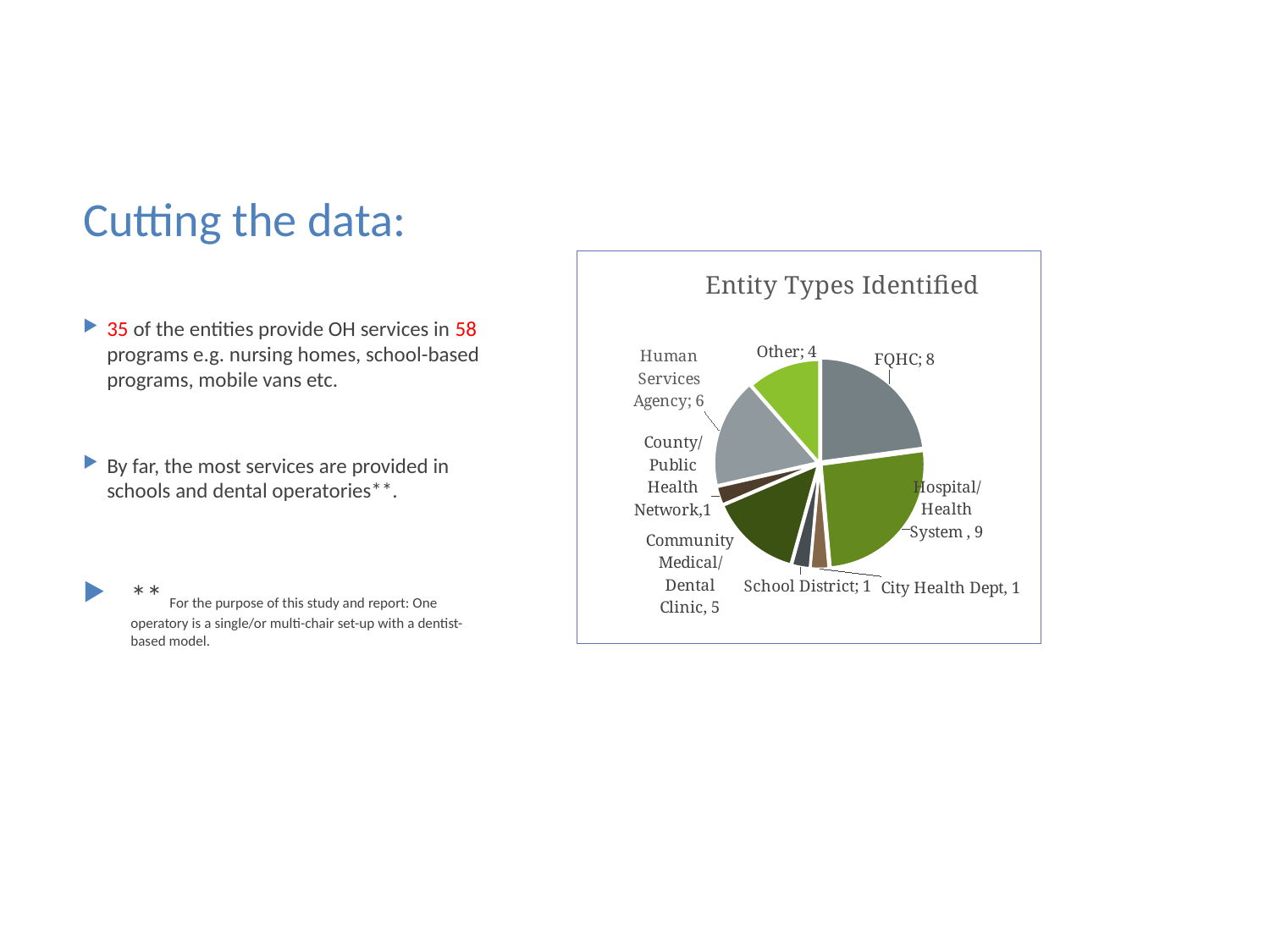
What is the value for Other? 4 What is the total of all the slices in the pie chart? 35 Which is larger, FQHC or Human Services Agency? FQHC What is the title of the chart? Entity Types Identified What is the difference between the Hospital/Health System value and the Community Medical/Dental Clinic value? 4 What is the value for FQHC? 8 Which entity type has the largest slice? Hospital/Health System What is the value for Community Medical/Dental Clinic? 5 How many entity types (slices) are shown in the pie chart? 8 What is the value for Human Services Agency? 6 What type of chart is shown on the slide? pie chart What is the value for Hospital/Health System? 9